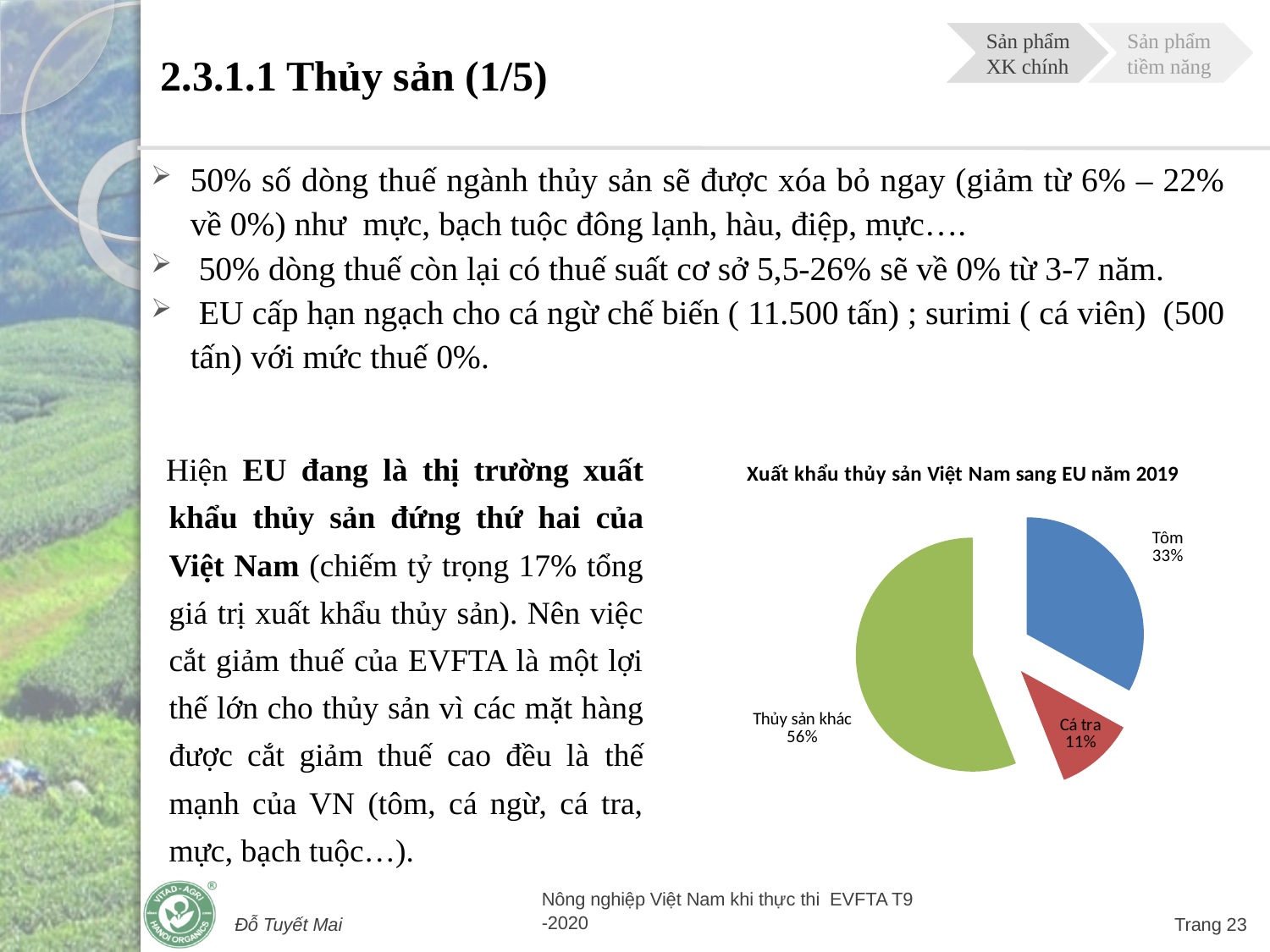
What share of the pie does Thủy sản khác represent? 56% How many categories are shown in the pie chart? 3 What is the combined share of Tôm and Cá tra? 44% What kind of chart is shown on the slide? Pie chart Which is larger, the Tôm slice or the Cá tra slice? Tôm What share of the pie does Tôm represent? 33% Which category has the largest slice of the pie? Thủy sản khác What colour is the Thủy sản khác slice? Green What is the difference in percentage points between the Tôm and Cá tra slices? 22% Which category has the smallest slice of the pie? Cá tra What is the title of the chart? Xuất khẩu thủy sản Việt Nam sang EU năm 2019 What share of the pie does Cá tra represent? 11%